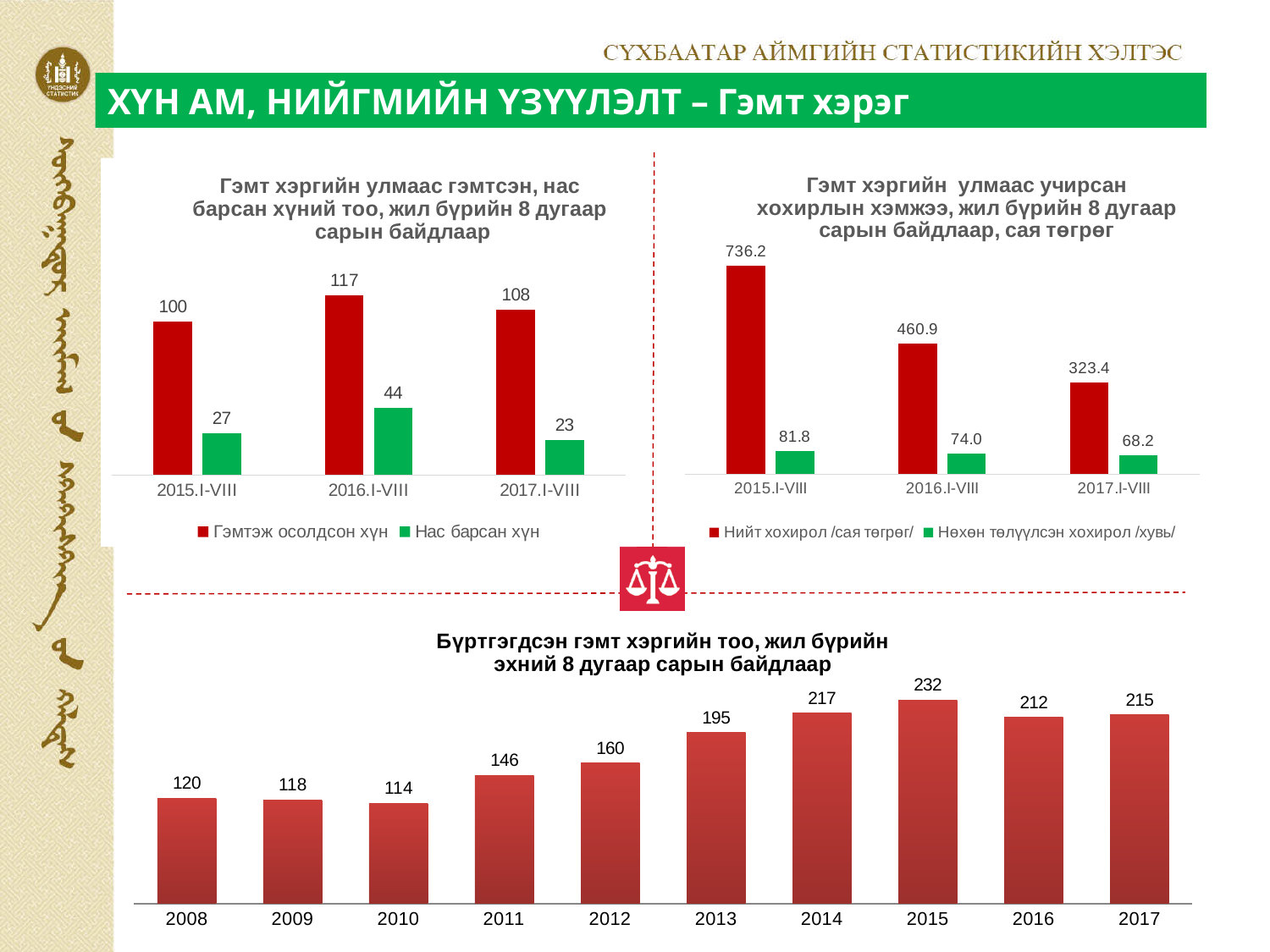
In the bottom chart (Бүртгэгдсэн гэмт хэргийн тоо), how many years are shown on the x axis? 10 In the top-right chart (Гэмт хэргийн улмаас учирсан хохирлын хэмжээ), does the value for Нийт хохирол rise or fall from 2015.I-VIII to 2017.I-VIII? fall In the bottom chart (Бүртгэгдсэн гэмт хэргийн тоо), which year has the lowest value? 2010 In the bottom chart (Бүртгэгдсэн гэмт хэргийн тоо), which year has the highest value? 2015 In the top-right chart (Гэмт хэргийн улмаас учирсан хохирлын хэмжээ), what is the value for Нөхөн төлүүлсэн хохирол in 2016.I-VIII? 74.0 In the top-left chart (Гэмт хэргийн улмаас гэмтсэн, нас барсан хүний тоо), what is the difference between Гэмтэж осолдсон хүн and Нас барсан хүн in 2015.I-VIII? 73 In the top-left chart (Гэмт хэргийн улмаас гэмтсэн, нас барсан хүний тоо), which period has the highest value for Нас барсан хүн? 2016.I-VIII In the top-left chart (Гэмт хэргийн улмаас гэмтсэн, нас барсан хүний тоо), what is the value for Гэмтэж осолдсон хүн in 2016.I-VIII? 117 In the bottom chart (Бүртгэгдсэн гэмт хэргийн тоо), what is the value for 2013? 195 In the top-right chart (Гэмт хэргийн улмаас учирсан хохирлын хэмжээ), what is the value for Нийт хохирол in 2015.I-VIII? 736.2 In the top-right chart (Гэмт хэргийн улмаас учирсан хохирлын хэмжээ), how many series does the legend list? 2 In the top-left chart (Гэмт хэргийн улмаас гэмтсэн, нас барсан хүний тоо), what is the value for Нас барсан хүн in 2017.I-VIII? 23